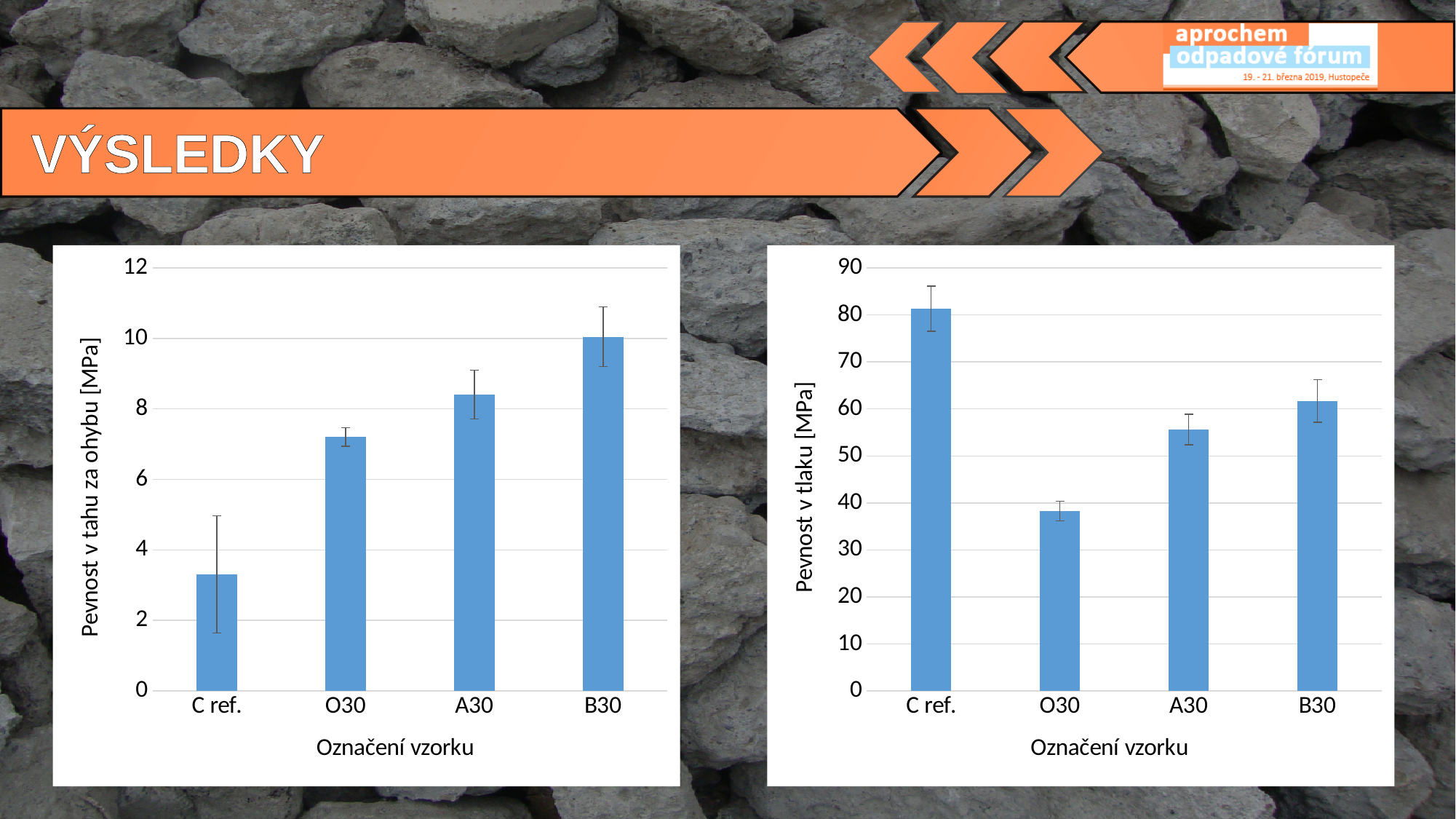
In the right chart (Pevnost v tlaku), which is larger, the value for A30 or the value for B30? B30 In the right chart (Pevnost v tlaku), is the value for C ref. greater or less than 80? greater How many samples are shown on the x axis of the left chart (Pevnost v tahu za ohybu)? 4 In the right chart (Pevnost v tlaku), which sample has the highest value? C ref. In the left chart (Pevnost v tahu za ohybu), is the value for C ref. greater or less than 4? less In the left chart (Pevnost v tahu za ohybu), which sample has the highest value? B30 What kind of chart is the right chart (Pevnost v tlaku)? bar chart In the left chart (Pevnost v tahu za ohybu), which sample has the lowest value? C ref. In the left chart (Pevnost v tahu za ohybu), is the value for A30 greater or less than 8? greater In the right chart (Pevnost v tlaku), which sample has the lowest value? O30 In the left chart, do the values rise or fall from C ref. to B30 along the x axis? rise